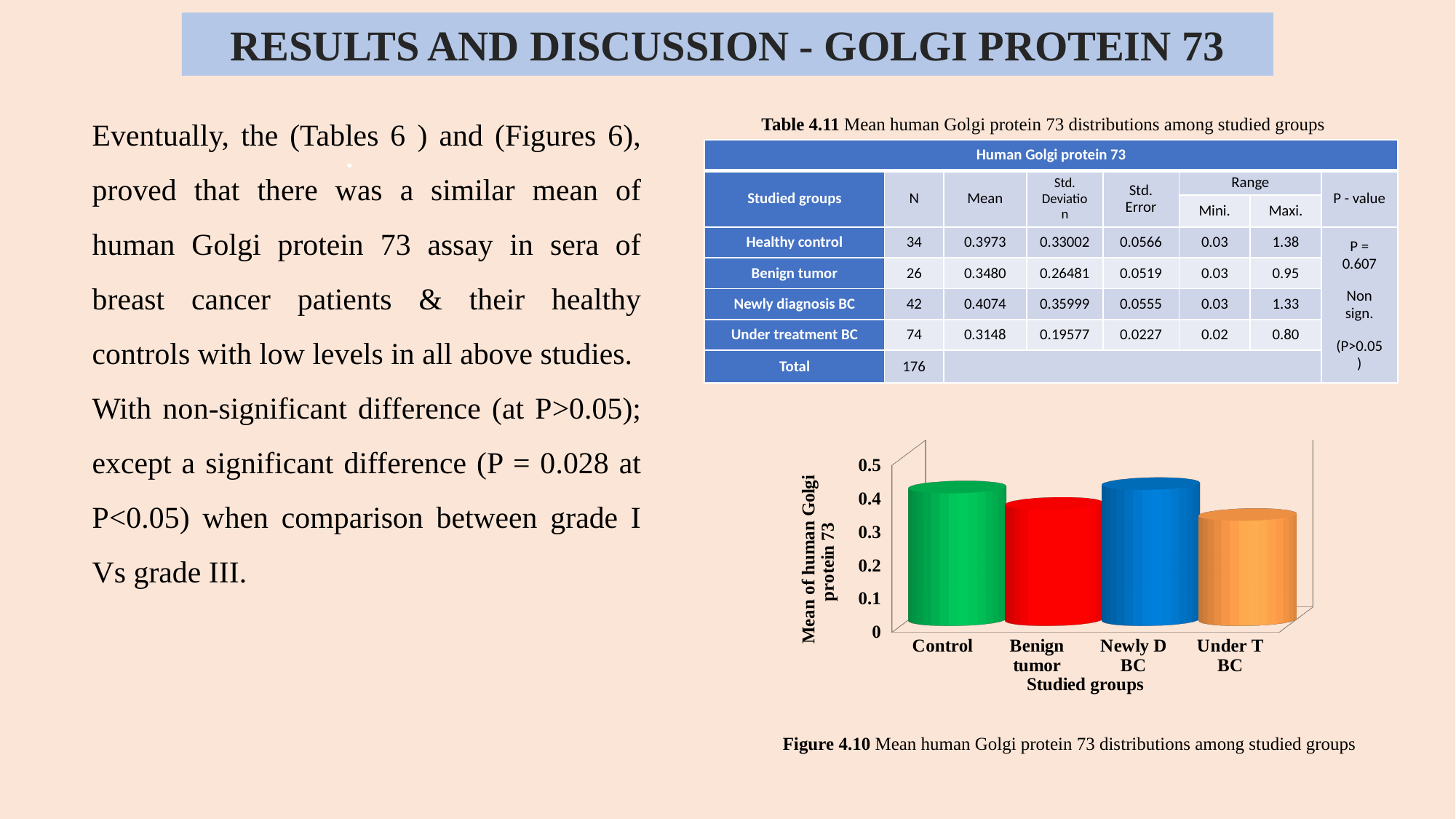
Which studied group has the lowest bar in the chart? Under T BC In the bar chart, which is larger: the value for Control or the value for Benign tumor? Control How many studied groups are plotted in the bar chart? 4 Is the value for Under T BC in the bar chart greater or less than 0.2? greater Is the value for Control in the bar chart greater or less than 0.3? greater What colour is the Benign tumor bar in the chart? red Is the value for Benign tumor in the bar chart greater or less than 0.4? less What is the label on the vertical axis of the bar chart? Mean of human Golgi protein 73 In the bar chart, which is larger: the value for Newly D BC or the value for Under T BC? Newly D BC What kind of chart is shown in Figure 4.10? bar chart